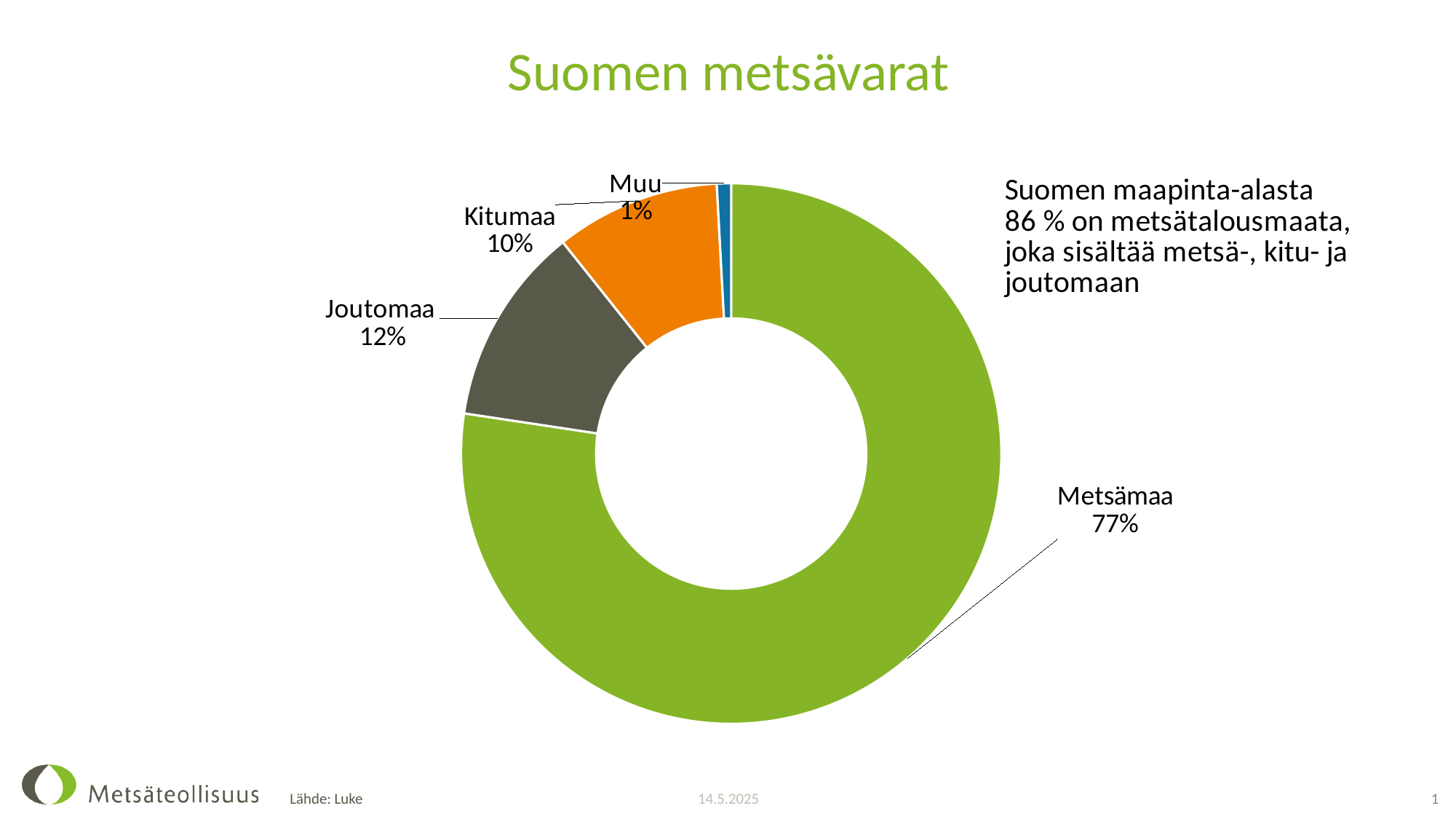
How many categories are shown in the chart? 4 What share of the donut chart does Metsämaa represent? 77% What kind of chart is shown on the slide? Donut (pie) chart What is the value shown for Muu? 1% What is the value shown for Kitumaa? 10% What is the difference between the shares of Joutomaa and Kitumaa? 2% Which category has the largest share of the chart? Metsämaa What is the difference between the shares of Metsämaa and Joutomaa? 65% What is the value shown for Joutomaa? 12% Which is larger, the share for Joutomaa or the share for Kitumaa? Joutomaa What is the title of the slide? Suomen metsävarat Which category has the smallest share of the chart? Muu